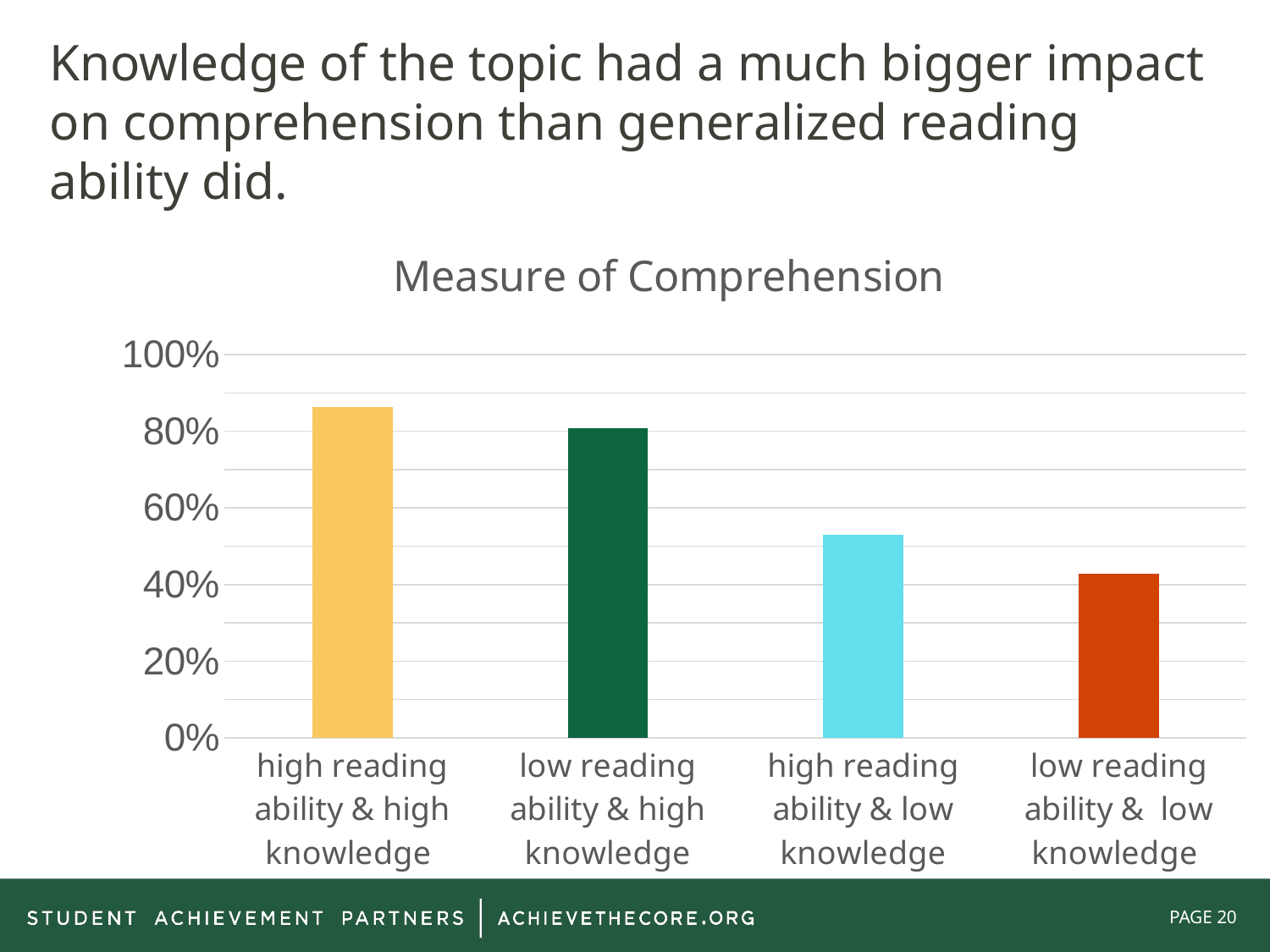
Which category has the highest value? high reading ability & high knowledge Which is larger: the value for low reading ability & high knowledge or the value for high reading ability & low knowledge? low reading ability & high knowledge Is the value for low reading ability & low knowledge greater or less than 60%? less What kind of chart is shown on the slide? bar chart How many categories are plotted in the chart? 4 Is the value for high reading ability & low knowledge greater or less than 60%? less Which is larger: the value for high reading ability & low knowledge or the value for low reading ability & low knowledge? high reading ability & low knowledge Is the value for low reading ability & high knowledge greater or less than 60%? greater Which category has the lowest value? low reading ability & low knowledge What is the title of the chart? Measure of Comprehension Do the values rise or fall from left to right across the categories? fall